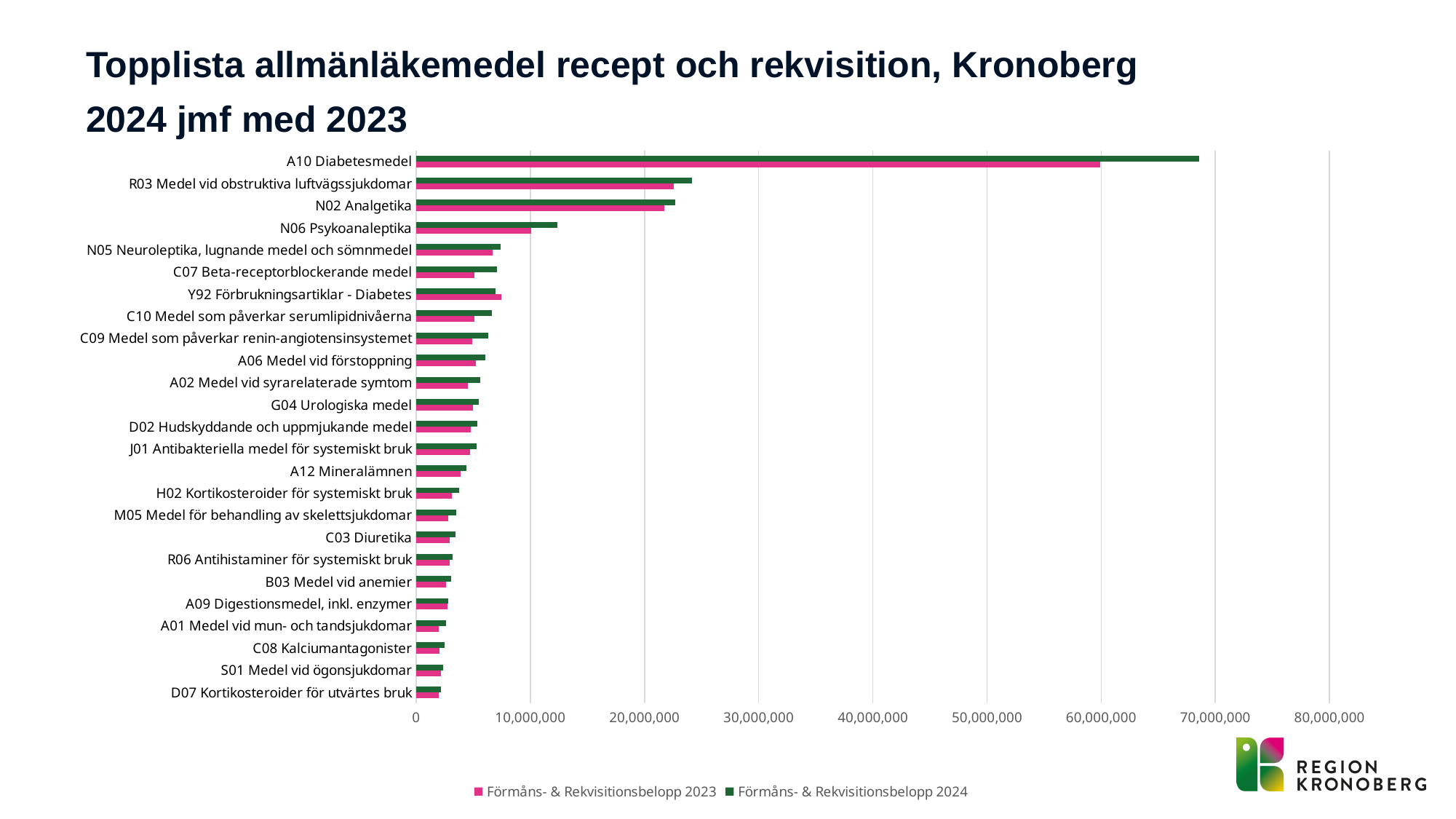
For A10 Diabetesmedel, which is larger: the 2023 value or the 2024 value? 2024 For N06 Psykoanaleptika, which is larger: the 2023 value or the 2024 value? 2024 Which category has the highest value for Förmåns- & Rekvisitionsbelopp 2024? A10 Diabetesmedel For Y92 Förbrukningsartiklar - Diabetes, which is larger: the 2023 value or the 2024 value? 2023 Is the 2024 value for R03 Medel vid obstruktiva luftvägssjukdomar greater or less than 20,000,000? greater Which colour represents Förmåns- & Rekvisitionsbelopp 2023 in the legend? Pink What kind of chart is shown on the slide? Bar chart How many series does the legend list? 2 Is the 2024 value for N05 Neuroleptika, lugnande medel och sömnmedel greater or less than 10,000,000? less How many categories (drug groups) are plotted on the chart? 25 Is the 2024 value for A10 Diabetesmedel greater or less than 60,000,000? greater Which category has the lowest value for Förmåns- & Rekvisitionsbelopp 2024? D07 Kortikosteroider för utvärtes bruk